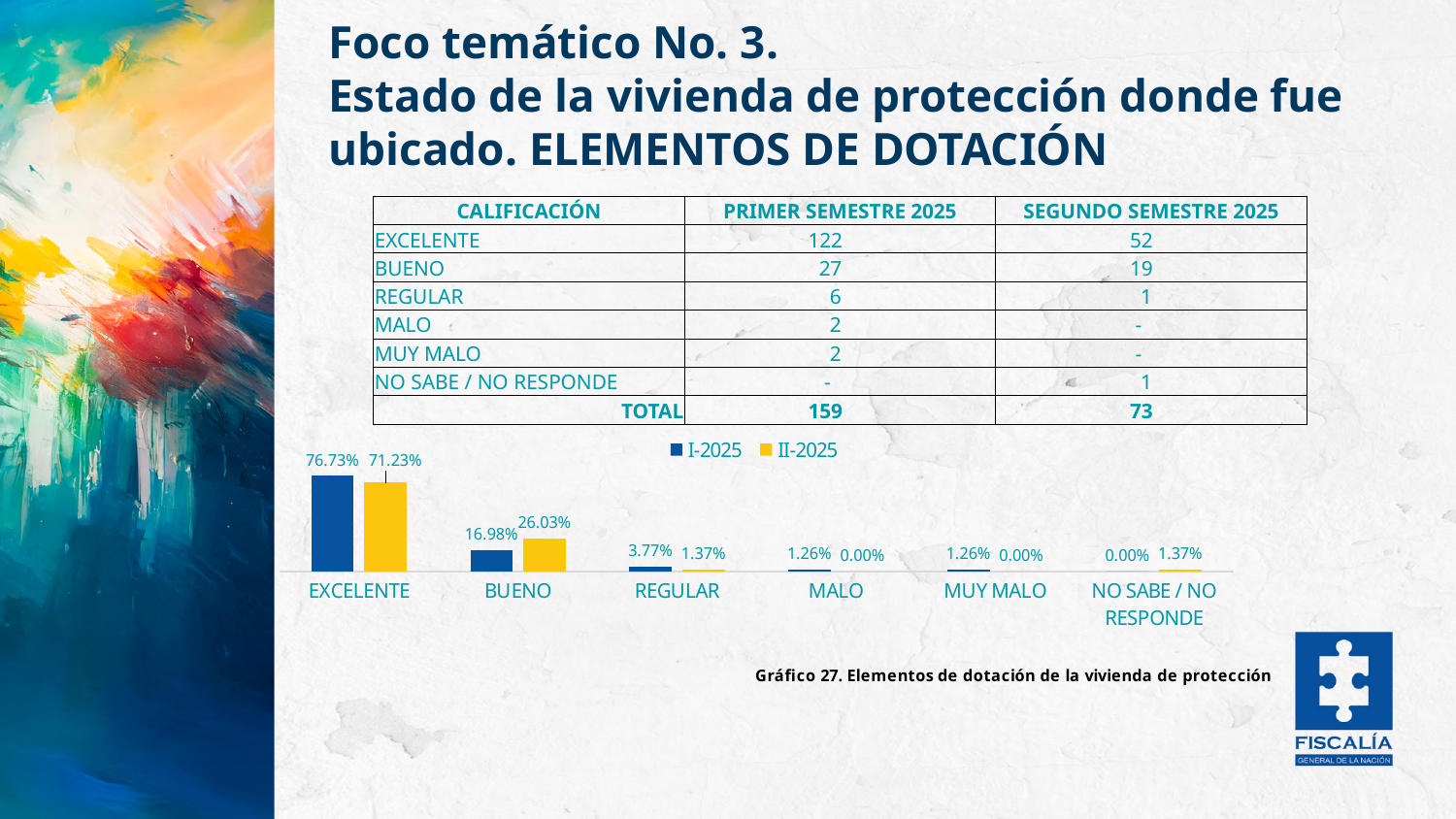
Which is larger for BUENO: the I-2025 value or the II-2025 value? II-2025 How many series does the chart legend list? 2 Which category has the highest value in the I-2025 series? EXCELENTE What is the value for REGULAR in the I-2025 series? 3.77% What is the caption printed below the chart? Gráfico 27. Elementos de dotación de la vivienda de protección How many categories are shown on the x axis of the chart? 6 What type of chart is shown on the slide? bar chart What is the value for NO SABE / NO RESPONDE in the II-2025 series? 1.37% What is the difference between the I-2025 and II-2025 values for EXCELENTE? 5.50% What is the value for BUENO in the II-2025 series? 26.03% What are the two series named in the chart legend? I-2025 and II-2025 What is the value for EXCELENTE in the I-2025 series? 76.73%